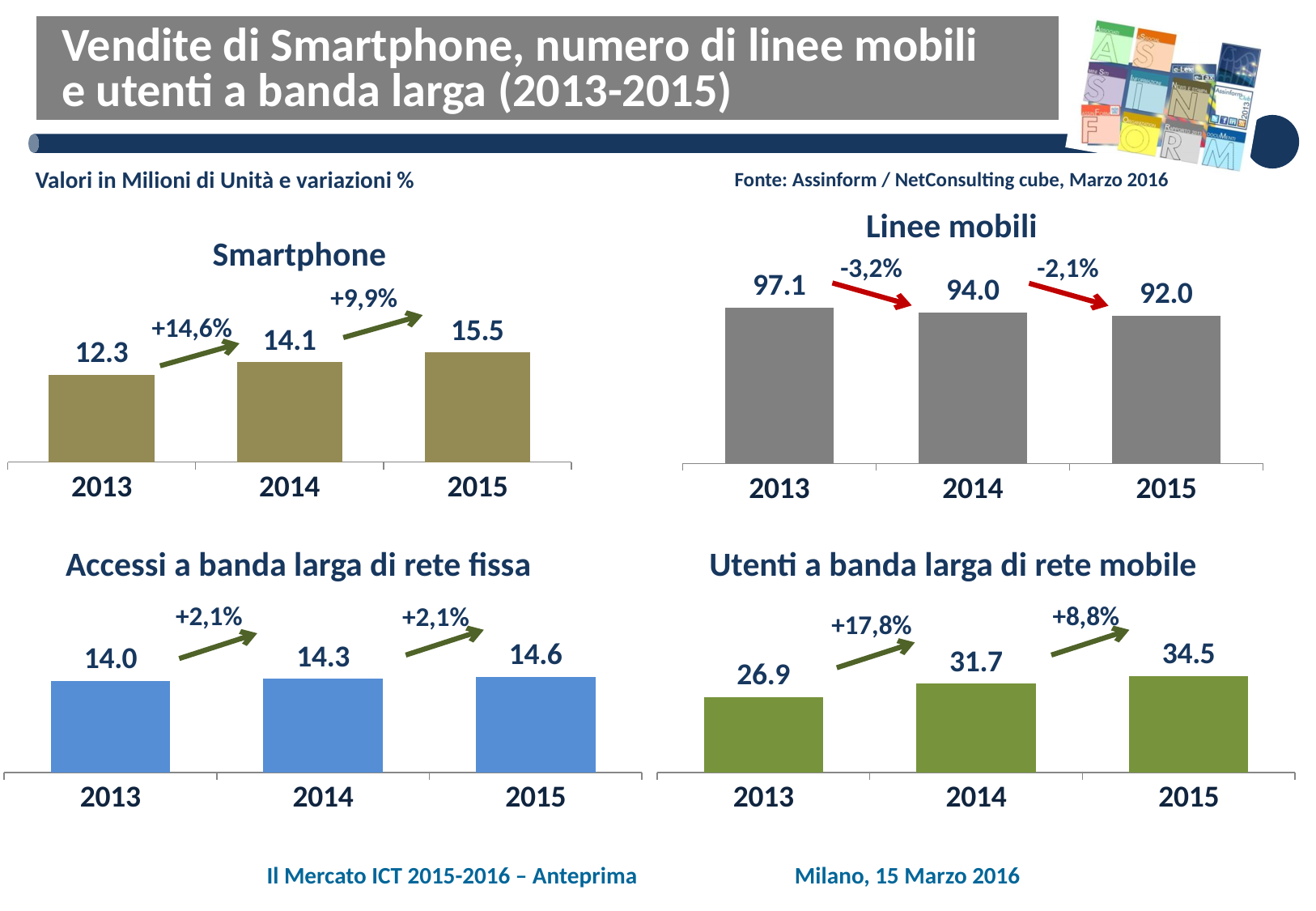
In the Smartphone chart, what is the difference between the 2015 and 2013 values? 3.2 How many years are shown in the Accessi a banda larga di rete fissa chart? 3 In the Linee mobili chart, what is the value for 2013? 97.1 In the Linee mobili chart, what is the difference between the 2013 and 2014 values? 3.1 In the Utenti a banda larga di rete mobile chart, what is the value for 2015? 34.5 In the Linee mobili chart, which year has the lowest value? 2015 In the Accessi a banda larga di rete fissa chart, what is the value for 2014? 14.3 In the Utenti a banda larga di rete mobile chart, which year has the highest value? 2015 Do the values in the Linee mobili chart rise or fall from 2013 to 2015? fall What kind of chart is the Smartphone chart? bar chart In the Smartphone chart, what is the value for 2015? 15.5 In the Utenti a banda larga di rete mobile chart, is the value for 2014 larger or smaller than the value for 2013? larger